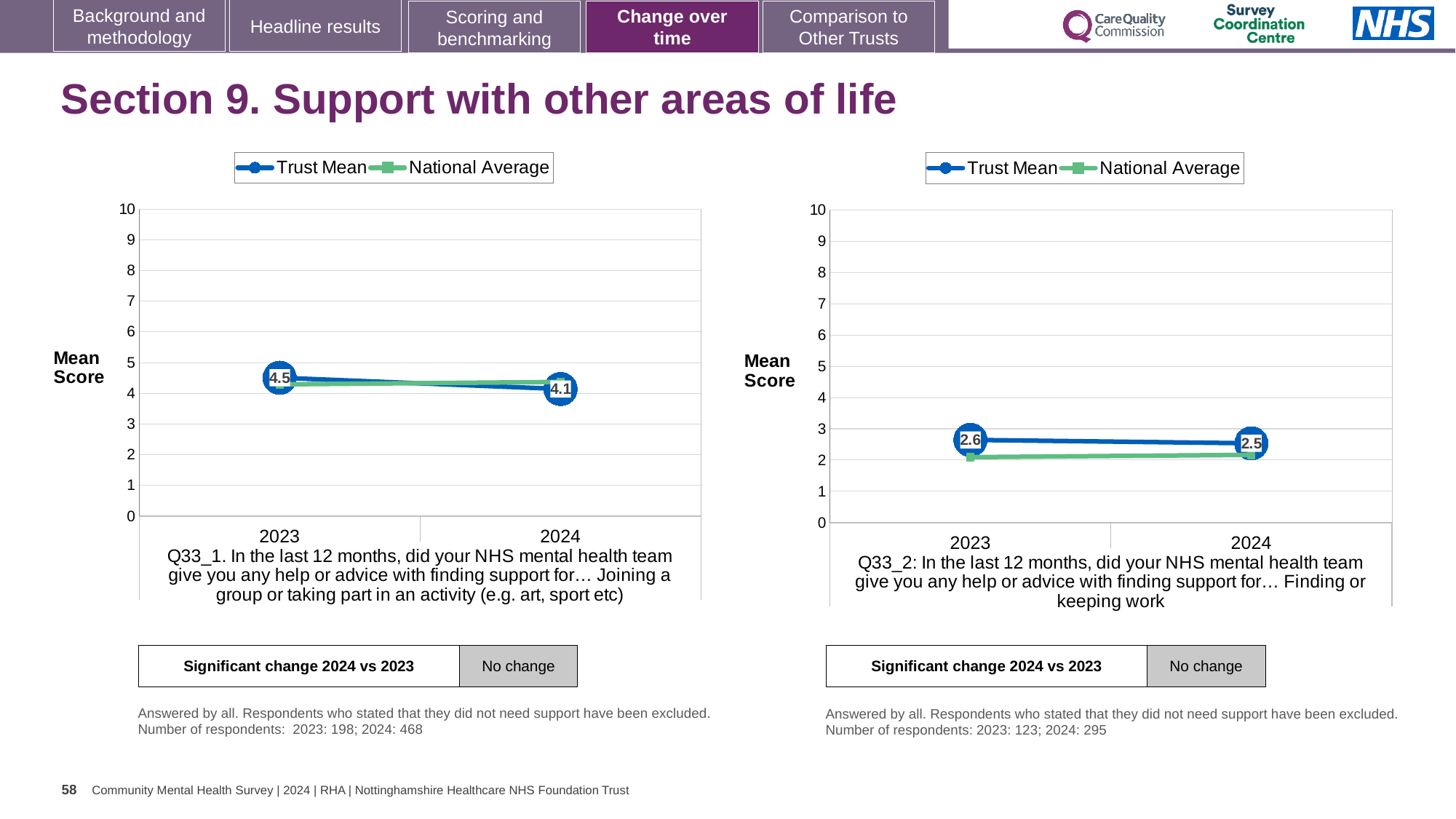
In the left chart (Q33_1), what is the Trust Mean score for 2024? 4.1 In the right chart (Q33_2), what is the difference between the Trust Mean in 2023 and 2024? 0.1 In the left chart (Q33_1), what is the Trust Mean score for 2023? 4.5 In the left chart (Q33_1), does the Trust Mean rise or fall from 2023 to 2024? fall In the right chart (Q33_2), what is the Trust Mean score for 2023? 2.6 In the right chart (Q33_2), is the National Average for 2023 greater or less than 3? less In the left chart (Q33_1), by how much did the Trust Mean change from 2023 to 2024? 0.4 In the right chart (Q33_2), which year has the higher Trust Mean, 2023 or 2024? 2023 In the right chart (Q33_2), which is larger in 2023, the Trust Mean or the National Average? Trust Mean How many series does the legend of the left chart list? 2 In the right chart (Q33_2), what is the Trust Mean score for 2024? 2.5 What type of chart is used for Q33_2 on the right? line chart